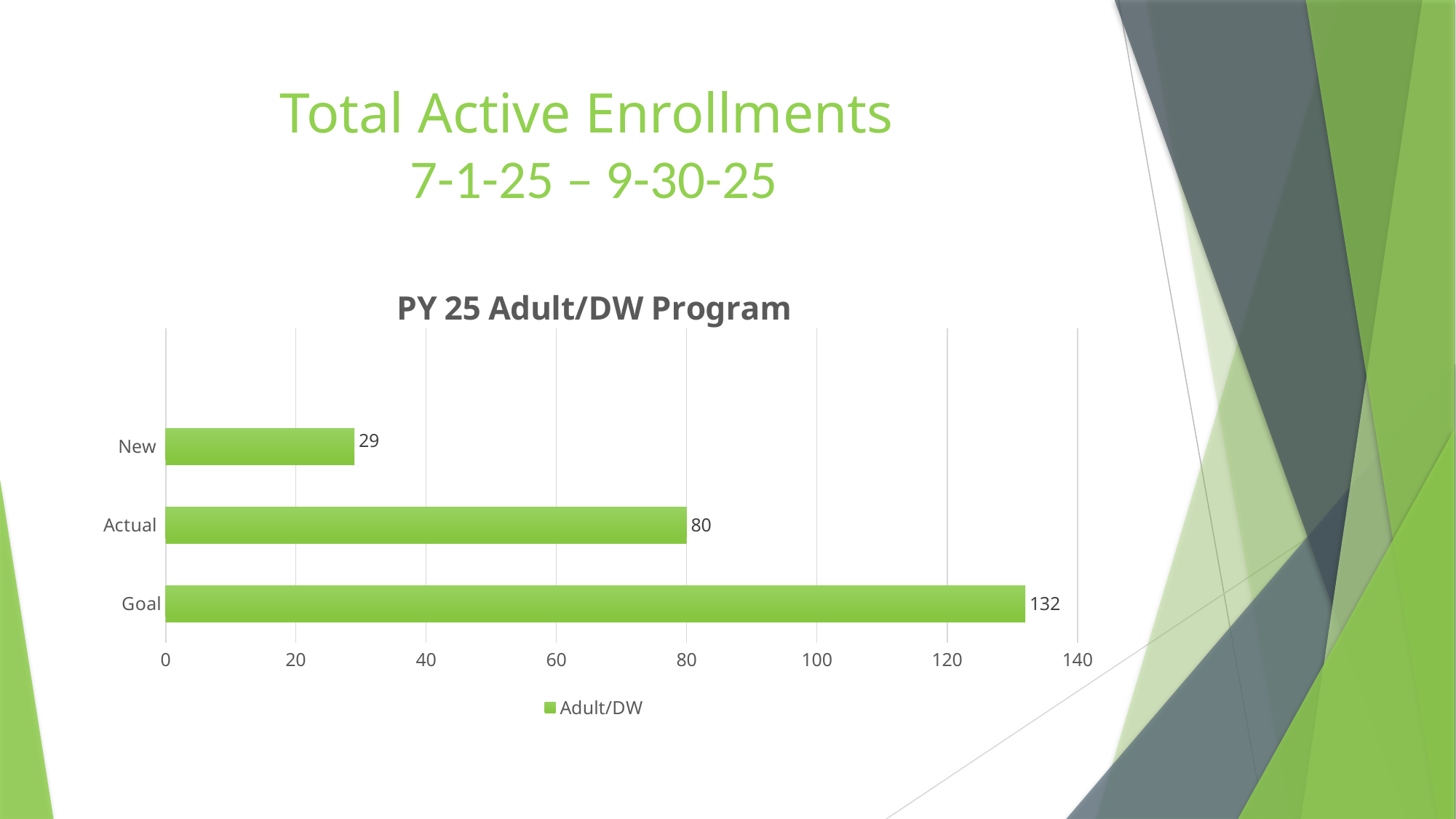
Which category has the highest value? Goal What is the value for New? 29 Is the value for Goal greater or less than 120? greater What is the value for Goal? 132 What is the difference between the Actual and New values? 51 What is the title of the chart? PY 25 Adult/DW Program What kind of chart is shown on the slide? Bar chart What is the difference between the Goal and Actual values? 52 Which is larger, the value for Actual or the value for New? Actual What is the value for Actual? 80 How many categories are shown in the chart? 3 Which category has the lowest value? New